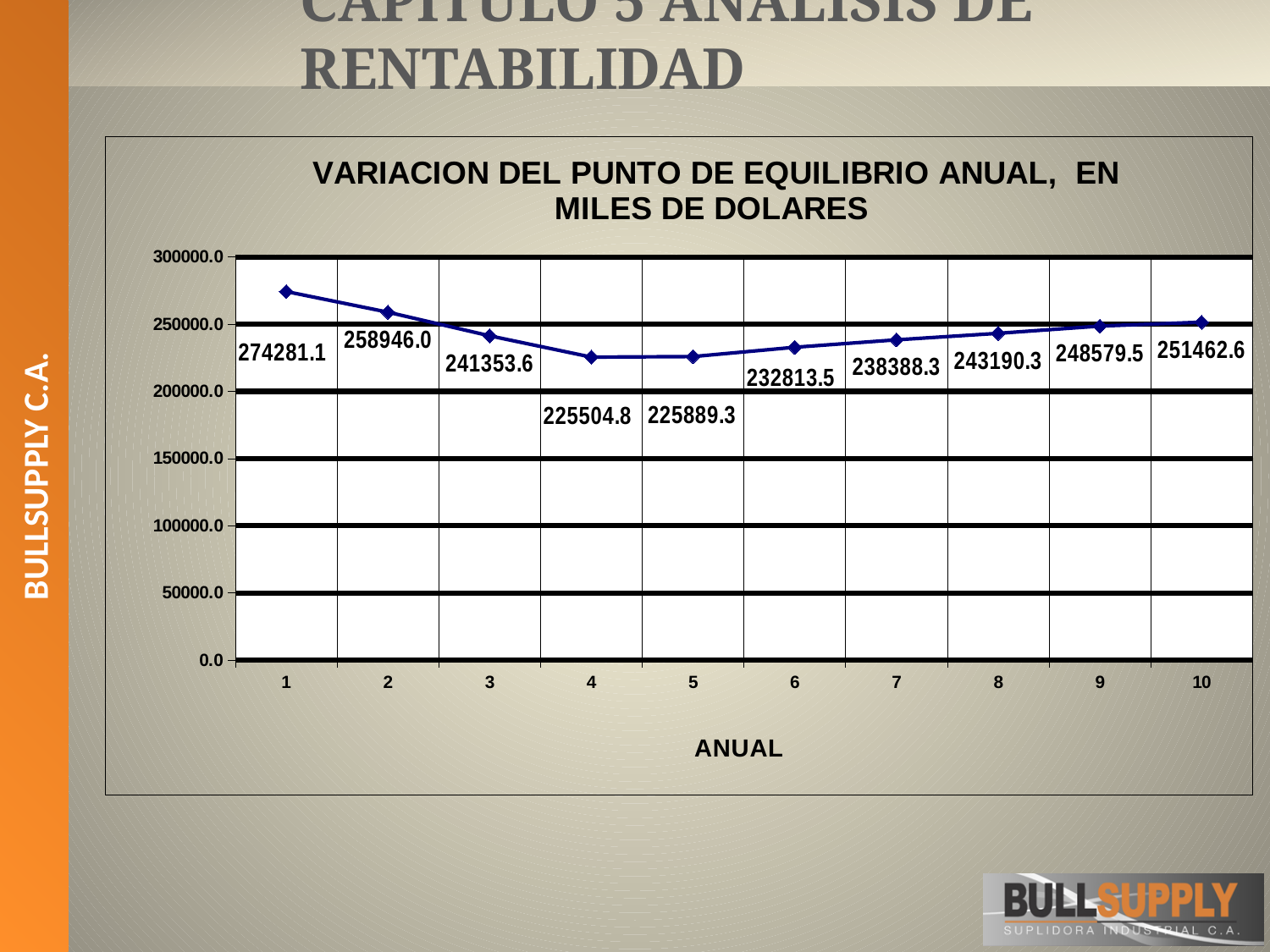
How many years are plotted on the x axis? 10 What is the difference between the values for year 2 and year 3? 17592.4 What is the value for year 6? 232813.5 Is the value for year 4 greater or less than 250000.0? less Which year has the lowest value? 4 Which year has the highest value? 1 Which is larger, the value for year 7 or the value for year 9? year 9 What is the value for year 1? 274281.1 What kind of chart is shown? line chart What is the difference between the values for year 1 and year 10? 22818.5 What is the label of the x axis? ANUAL What is the value for year 10? 251462.6